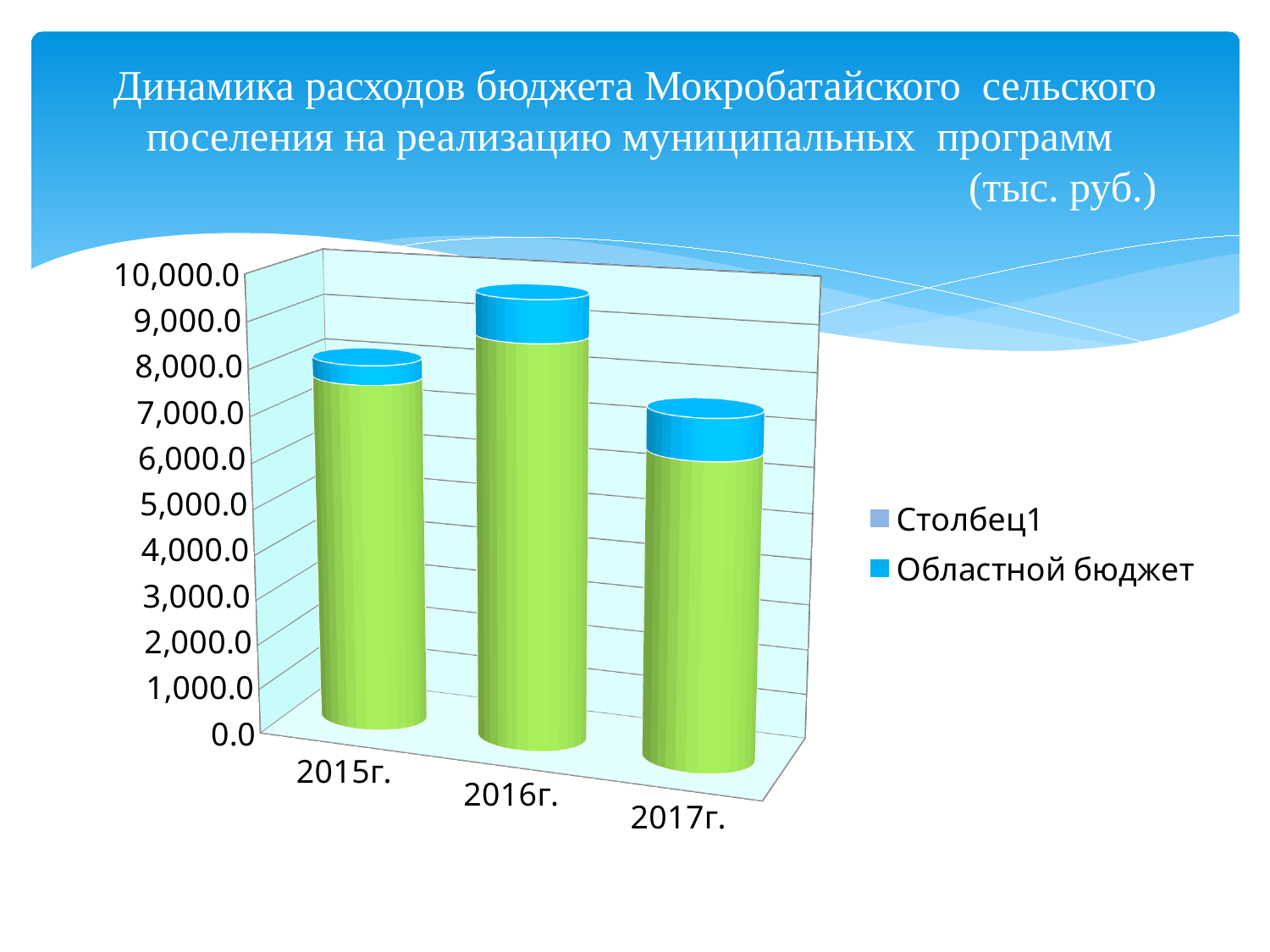
How many years (categories) are shown on the x axis? 3 Which stacked bar is taller, 2015г. or 2017г.? 2015г. Is the total value for 2017г. greater or less than 6,000.0? greater How many series does the legend list? 2 Which year has the shortest stacked bar? 2017г. What unit of measurement is stated in the chart title? тыс. руб. Do the stacked bar totals rise or fall from 2016г. to 2017г.? fall What kind of chart is shown on the slide? bar chart Is the total stacked bar for 2016г. taller or shorter than the bar for 2015г.? taller Which year has the tallest stacked bar? 2016г. Is the total value for 2016г. greater or less than 8,000.0? greater Is the total value for 2015г. greater or less than 7,000.0? greater